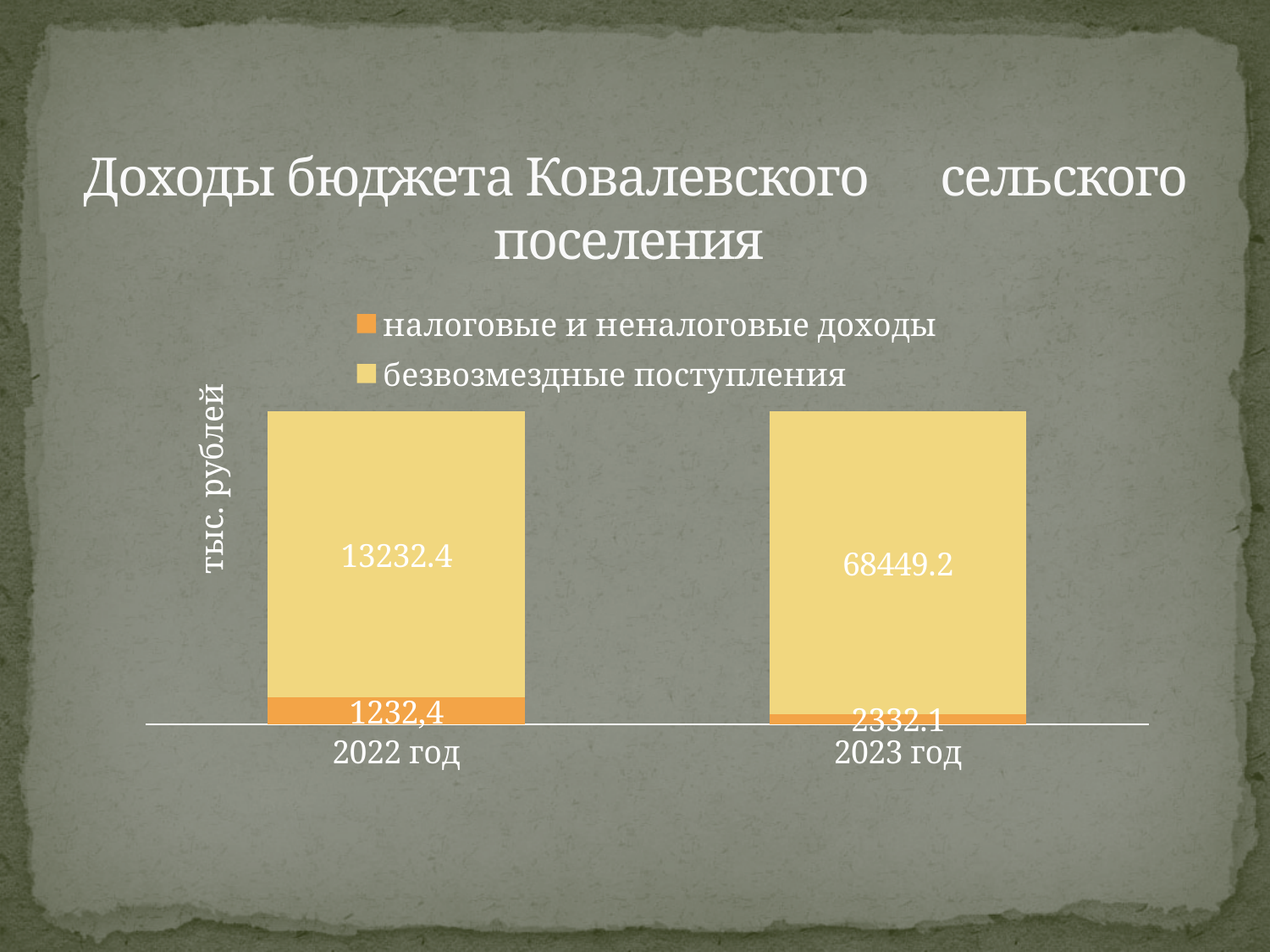
How many series does the legend list? 2 What is the value of безвозмездные поступления for 2022 год? 13232.4 What is the difference between безвозмездные поступления in 2023 год and 2022 год? 55216.8 What is the label on the vertical axis? тыс. рублей How many categories are shown on the x axis? 2 What is the value of безвозмездные поступления for 2023 год? 68449.2 What is the difference between налоговые и неналоговые доходы in 2023 год and 2022 год? 1099.7 Which year has the higher value of безвозмездные поступления, 2022 год or 2023 год? 2023 год What is the value of налоговые и неналоговые доходы for 2023 год? 2332.1 What is the value of налоговые и неналоговые доходы for 2022 год? 1232,4 What is the total of the stacked bar for 2023 год? 70781.3 What type of chart is shown on the slide? Stacked bar chart